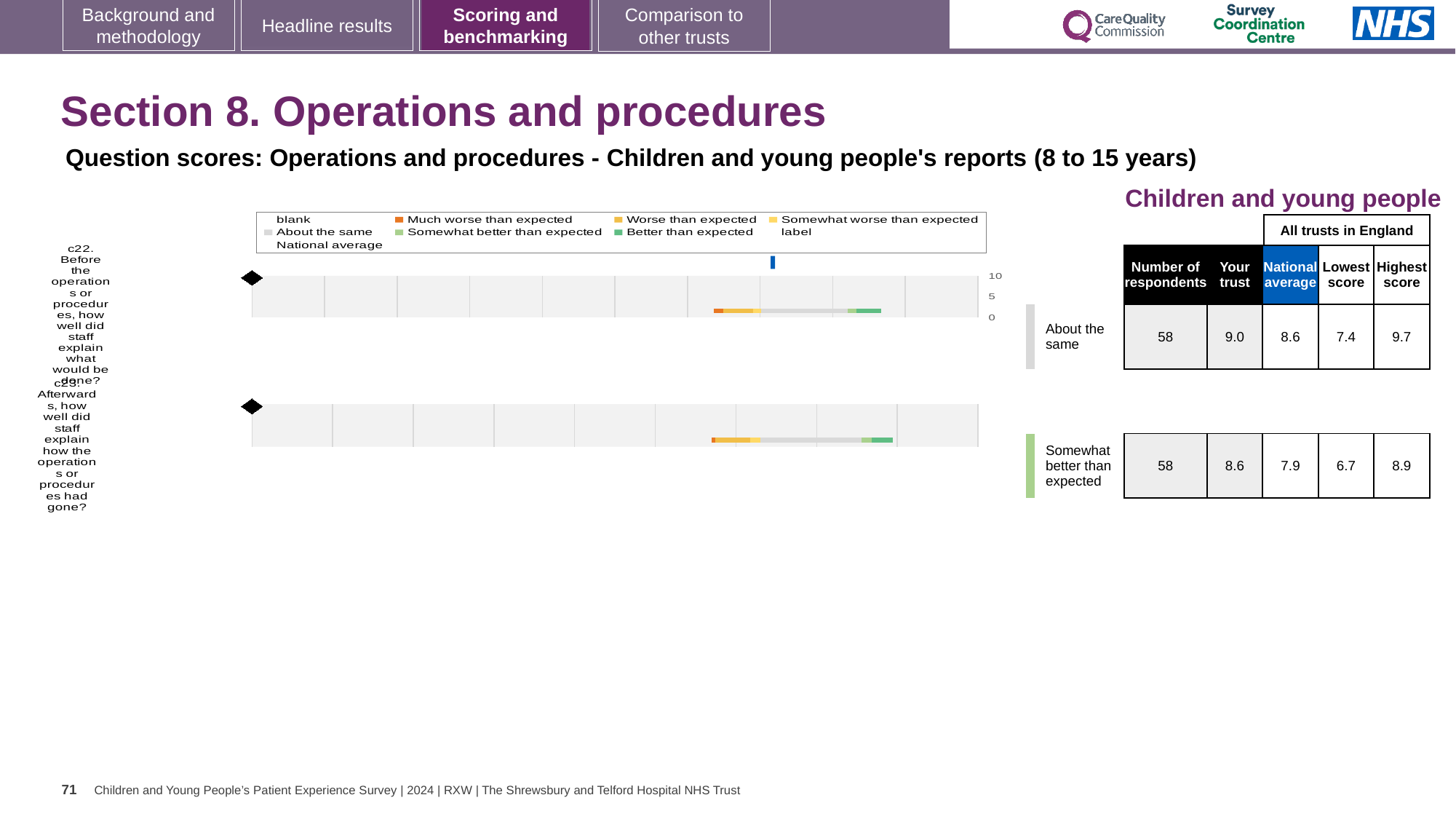
What kind of chart is used to show the question scores for c22 and c23? bar chart For c23 (Afterwards, how well did staff explain how the operations or procedures had gone?), what is the 'Your trust' score? 8.6 How many respondents answered c23? 58 How many questions (c22 and c23) are plotted on the slide? 2 For c22, is the trust's score higher or lower than the national average? higher What is the maximum value shown on the score axis of the charts? 10 Which benchmark category is the trust's c23 score placed in? Somewhat better than expected What is the difference between the highest and lowest scores for c22? 2.3 What is the difference between the trust's score and the national average for c23? 0.7 For c22, what is the national average score? 8.6 For c22 (Before the operations or procedures, how well did staff explain what would be done?), what is the 'Your trust' score? 9.0 For c23, what is the highest score among all trusts in England? 8.9